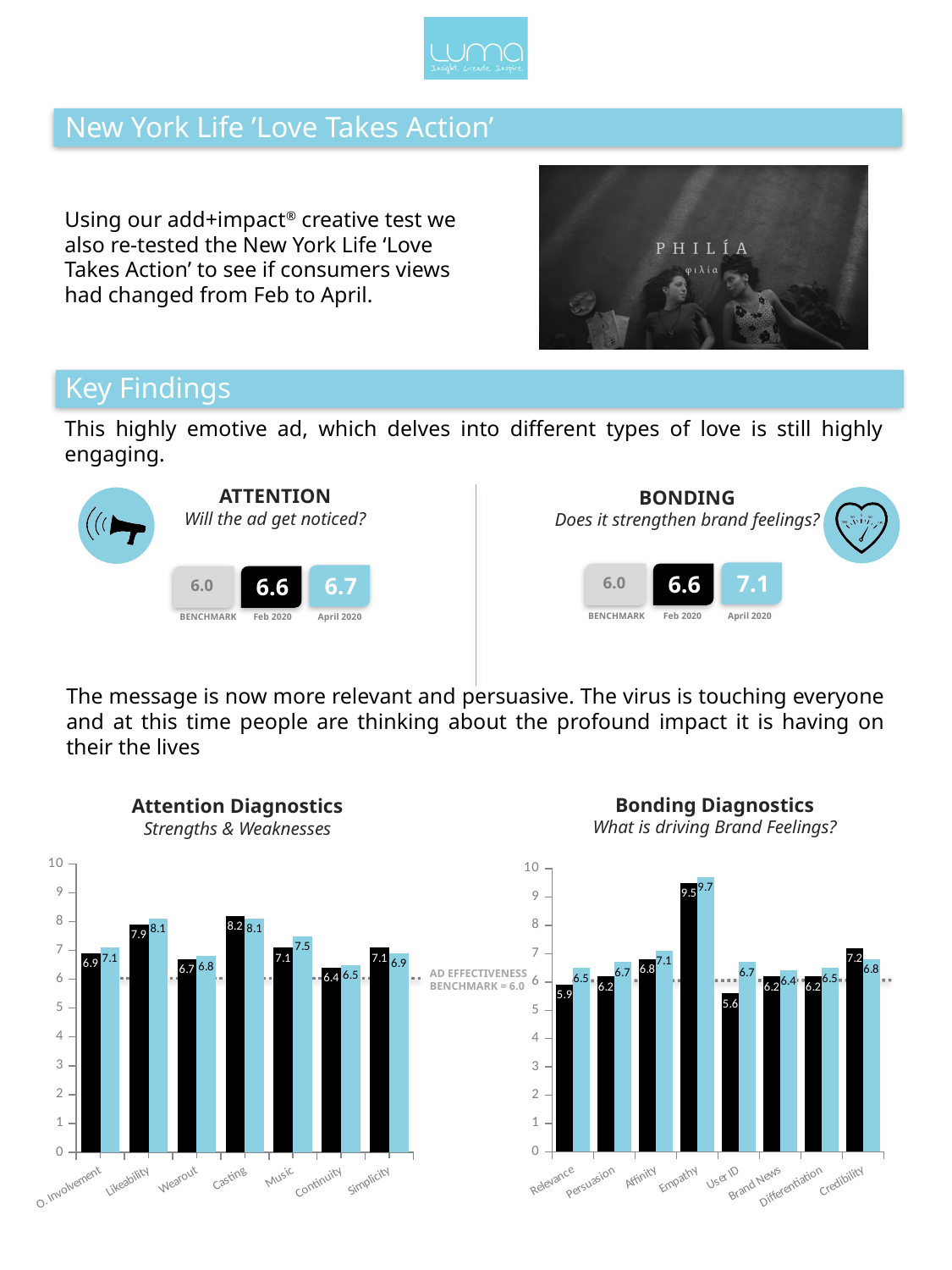
In the Attention Diagnostics chart, what is the value of the black bar for Casting? 8.2 In the Bonding Diagnostics chart, what is the value of the blue bar for Empathy? 9.7 What type of chart is the Attention Diagnostics chart? bar chart In the Attention Diagnostics chart, what is the value of the blue bar for Music? 7.5 In the Bonding Diagnostics chart, which category has the lowest black bar? User ID In the Attention Diagnostics chart, what is the difference between the blue bar and the black bar for Music? 0.4 In the Attention Diagnostics chart, how many categories are shown on the x axis? 7 In the Bonding Diagnostics chart, what is the difference between the blue bar and the black bar for User ID? 1.1 In the Bonding Diagnostics chart, which is larger for Credibility: the black bar or the blue bar? the black bar In the Bonding Diagnostics chart, which category has the highest bars? Empathy In the Attention Diagnostics chart, which category has the lowest black bar? Continuity In the Bonding Diagnostics chart, how many categories are shown on the x axis? 8